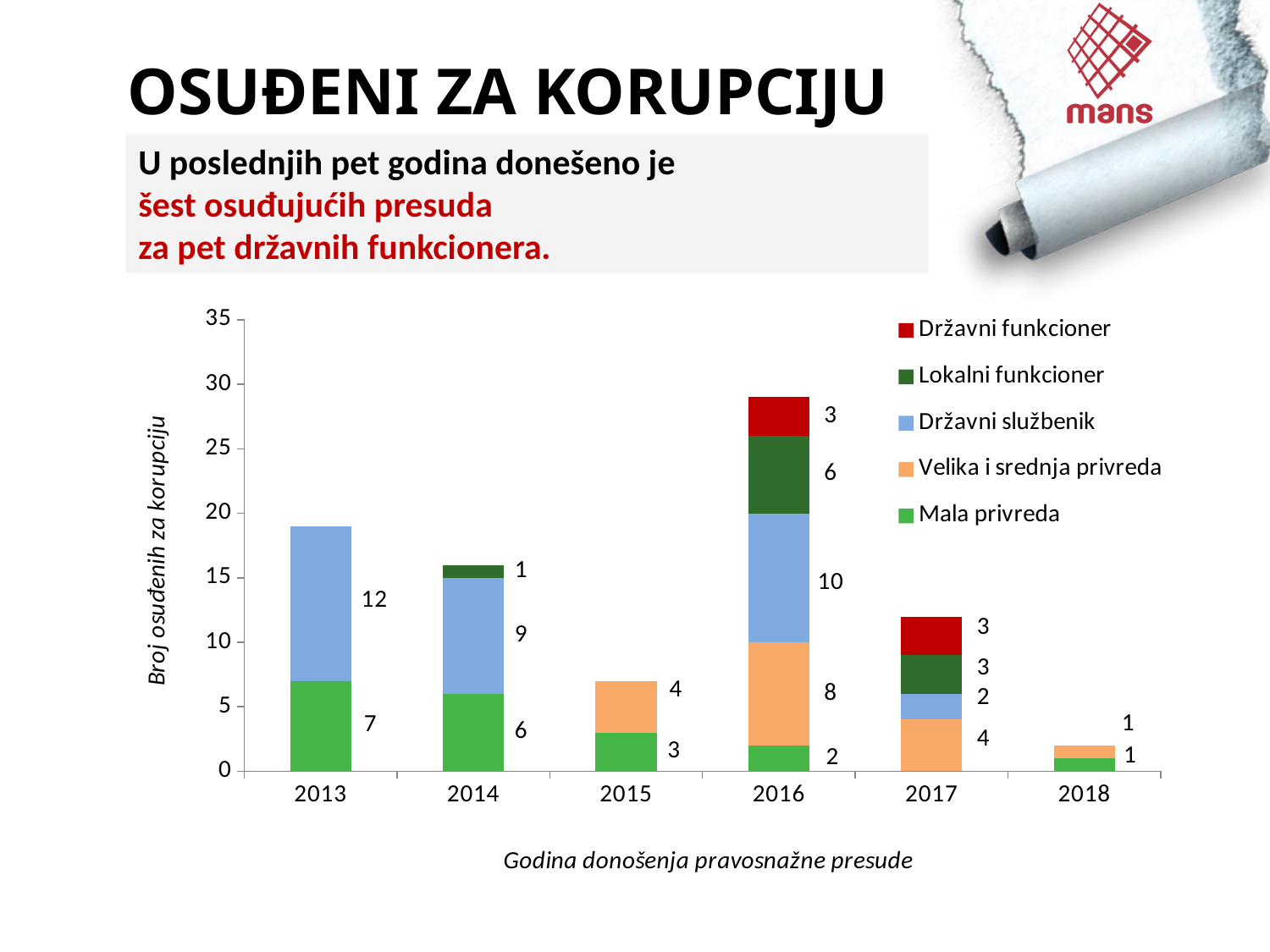
What is the difference between the Mala privreda values for 2013 and 2014? 1 What is the value for Velika i srednja privreda in 2016? 8 What kind of chart is shown on the slide? stacked bar chart What is the value for Lokalni funkcioner in 2014? 1 What is the total of the stacked bar for 2016? 29 Which year has the lowest total number of convicted persons? 2018 What is the value for Državni službenik in 2013? 12 How many years are shown on the x axis? 6 What is the total of the stacked bar for 2017? 12 Which year has the highest total number of convicted persons? 2016 Which is larger: the Državni službenik value in 2016 or in 2017? 2016 How many series does the legend list? 5